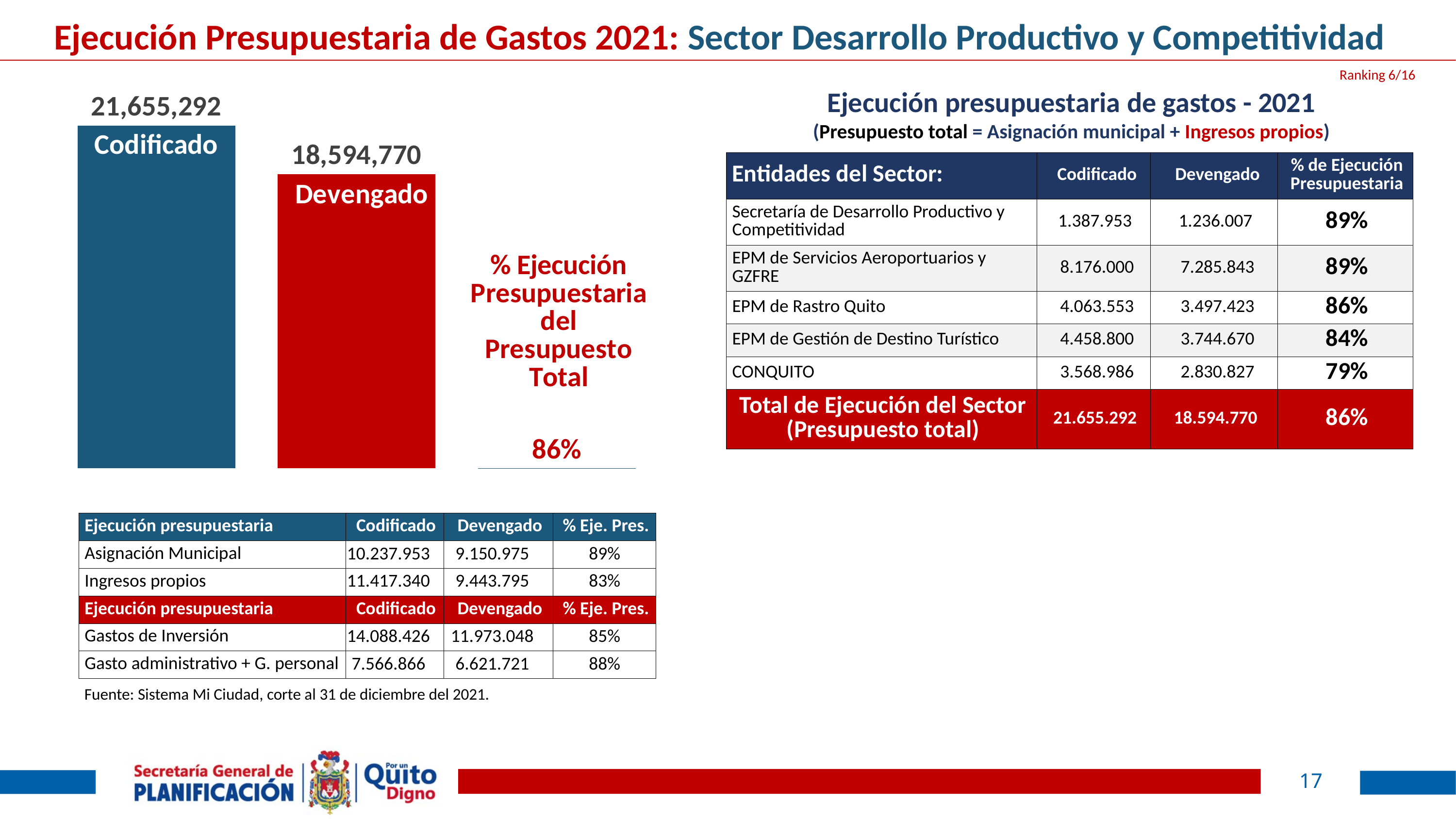
What is the value of the Devengado bar in the bar chart? 18,594,770 What percentage is shown next to the bar chart as the % Ejecución Presupuestaria del Presupuesto Total? 86% What colour is the Devengado bar in the chart? Red Which bar in the chart is the highest? Codificado How many bars are shown in the bar chart? 2 Which is larger in the bar chart, Codificado or Devengado? Codificado Which bar in the chart is the lowest? Devengado What type of chart is shown on the left of the slide? Bar chart What is the value of the Codificado bar in the bar chart? 21,655,292 What is the difference between the Codificado and Devengado bars in the chart? 3,060,522 What colour is the Codificado bar in the chart? Blue